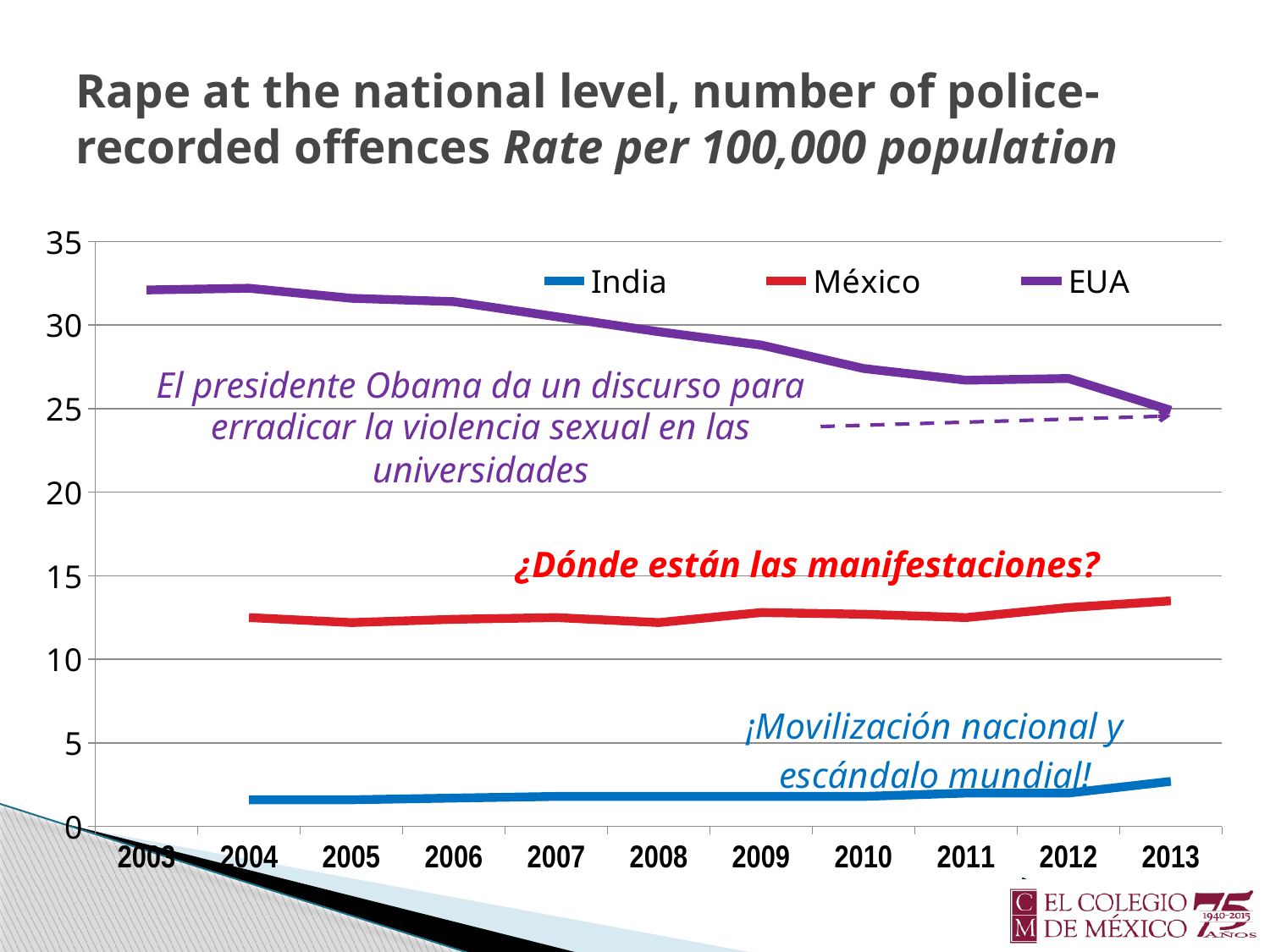
How many series does the legend list? 3 What kind of chart is shown on the slide? line chart Is the value for EUA in 2013 greater or less than 30? less Is the value for México in 2013 greater or less than 10? greater Which series has the lowest values across the chart? India Which series is drawn in red in the legend? México Which series has the highest values across the chart? EUA Which is larger in 2010, the value for México or the value for India? México Is the value for India in 2013 greater or less than 5? less Does the EUA line rise or fall from 2003 to 2013? fall How many years are shown on the x axis? 11